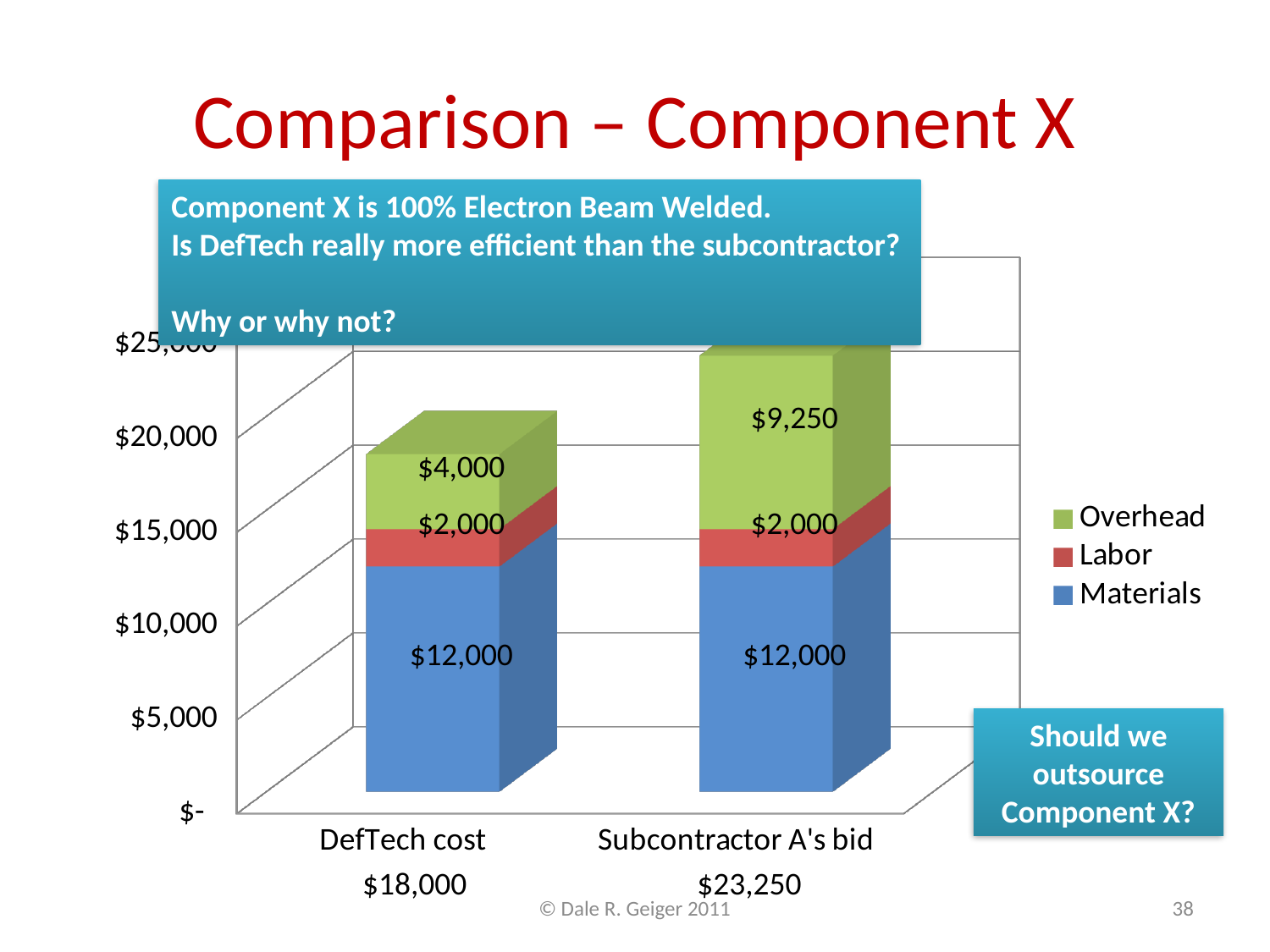
What kind of chart is shown on the slide? Stacked bar chart How many categories are shown on the x axis? 2 What is the total of the stacked bar for DefTech cost? $18,000 What is the difference in Overhead between Subcontractor A's bid and DefTech cost? $5,250 How many series does the legend list? 3 What is the Labor value for Subcontractor A's bid? $2,000 Which colour represents Materials in the legend? Blue What is the Overhead value for DefTech cost? $4,000 What is the Materials value for DefTech cost? $12,000 Which category has the higher Overhead value, DefTech cost or Subcontractor A's bid? Subcontractor A's bid What is the Overhead value for Subcontractor A's bid? $9,250 What is the total of the stacked bar for Subcontractor A's bid? $23,250